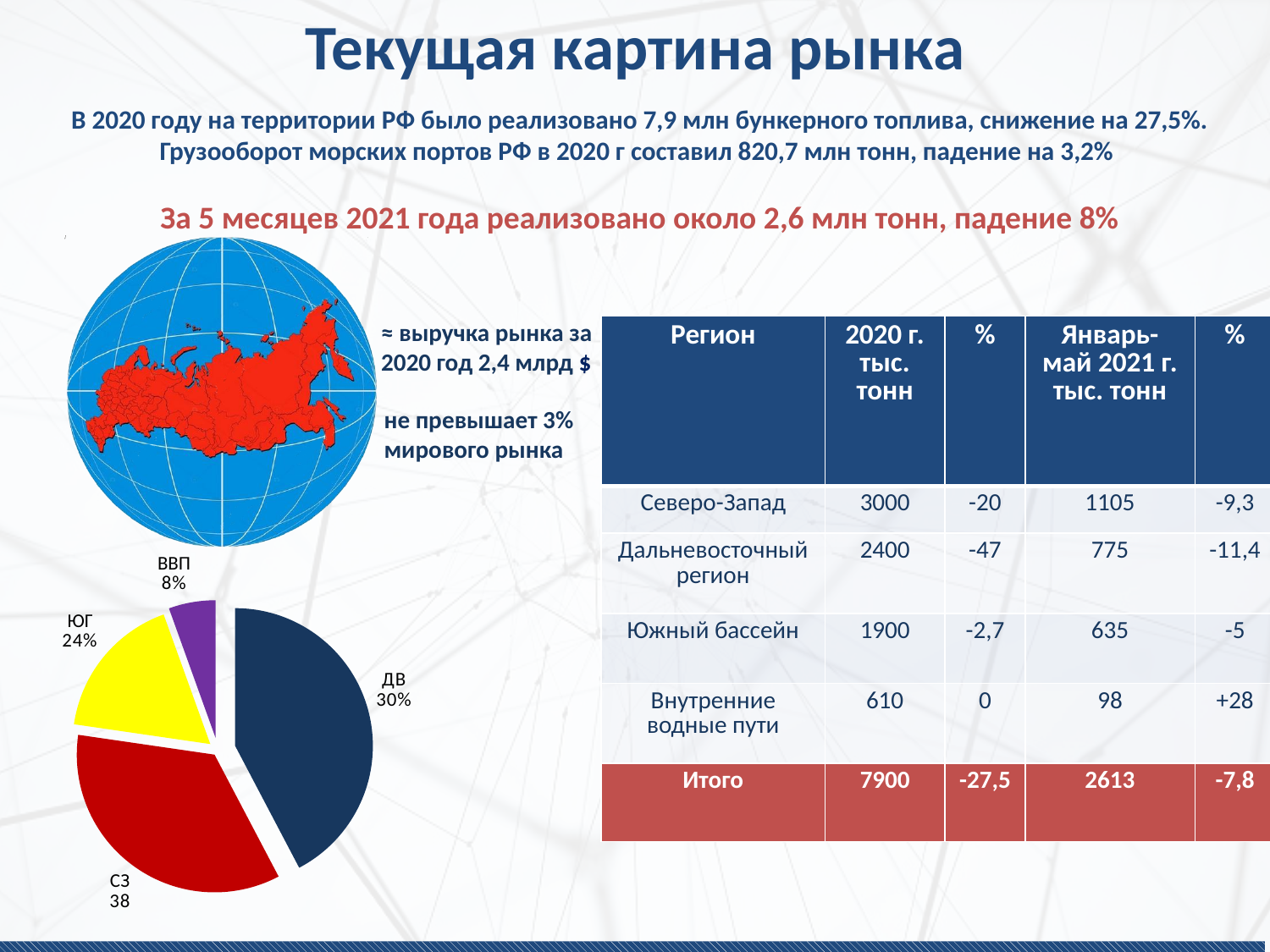
What is the value shown for the ЮГ slice of the pie chart? 24% What kind of chart is shown on the slide? pie chart In the pie chart, which is larger, ДВ or ЮГ? ДВ What colour is the ЮГ slice of the pie chart? yellow What is the value shown for the ДВ slice of the pie chart? 30% What is the value shown for the СЗ slice of the pie chart? 38 What is the difference in percentage points between the ДВ and ВВП slices of the pie chart? 22 How many slices does the pie chart have? 4 What is the value shown for the ВВП slice of the pie chart? 8% Which slice of the pie chart is the smallest? ВВП What colour is the СЗ slice of the pie chart? red